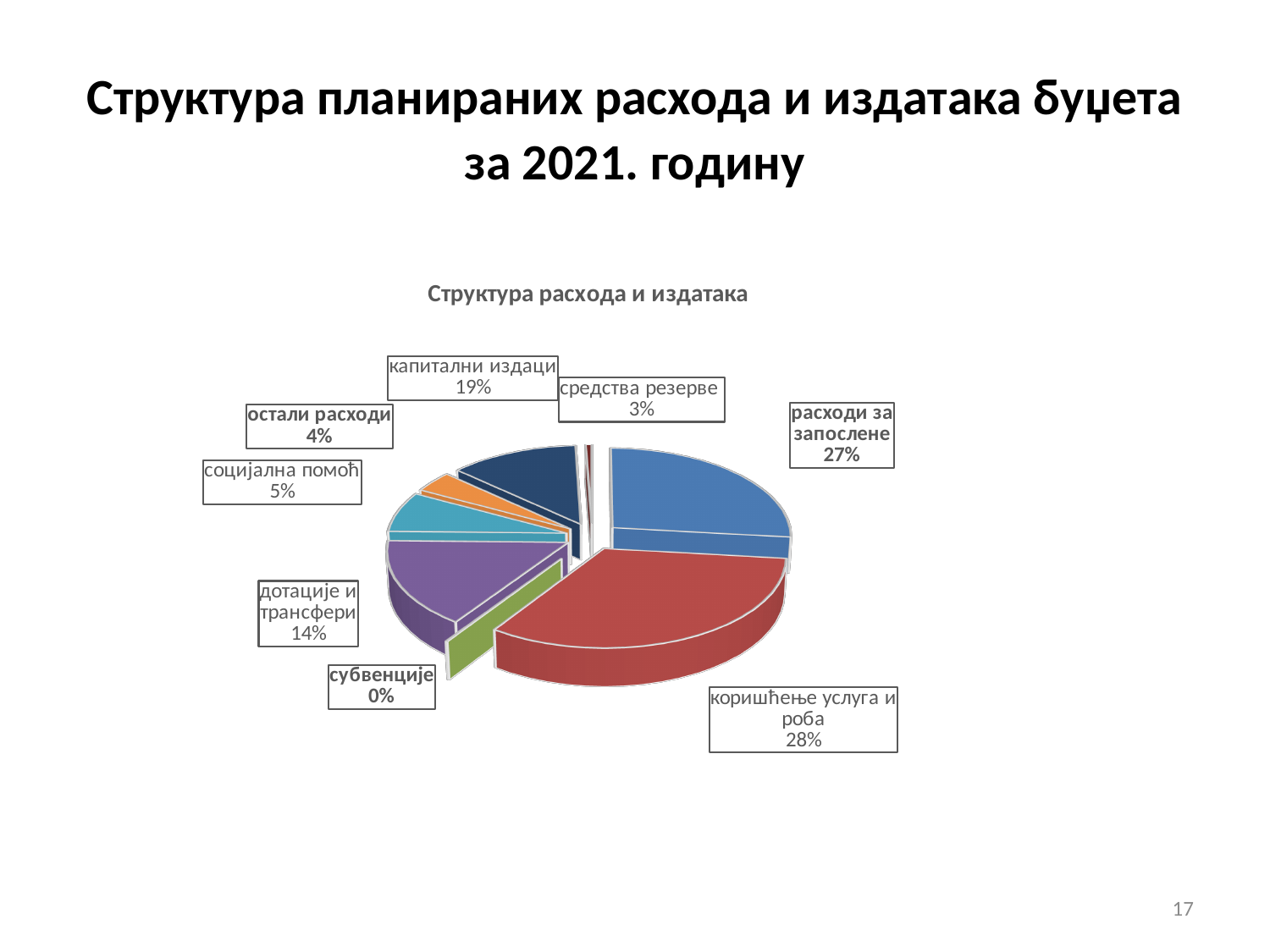
Which category has the largest share of the pie? коришћење услуга и роба What percentage is shown for расходи за запослене? 27% What share of the pie is labelled for капитални издаци? 19% What percentage is shown for дотације и трансфери? 14% What is the combined share of расходи за запослене and коришћење услуга и роба? 55% What is the difference in percentage points between капитални издаци and дотације и трансфери? 5 What kind of chart is shown on the slide? pie chart Which category has the smallest share of the pie? субвенције What percentage is shown for средства резерве? 3% Which is larger, социјална помоћ or остали расходи? социјална помоћ What is the title of the chart? Структура расхода и издатака How many categories are shown in the pie chart? 8